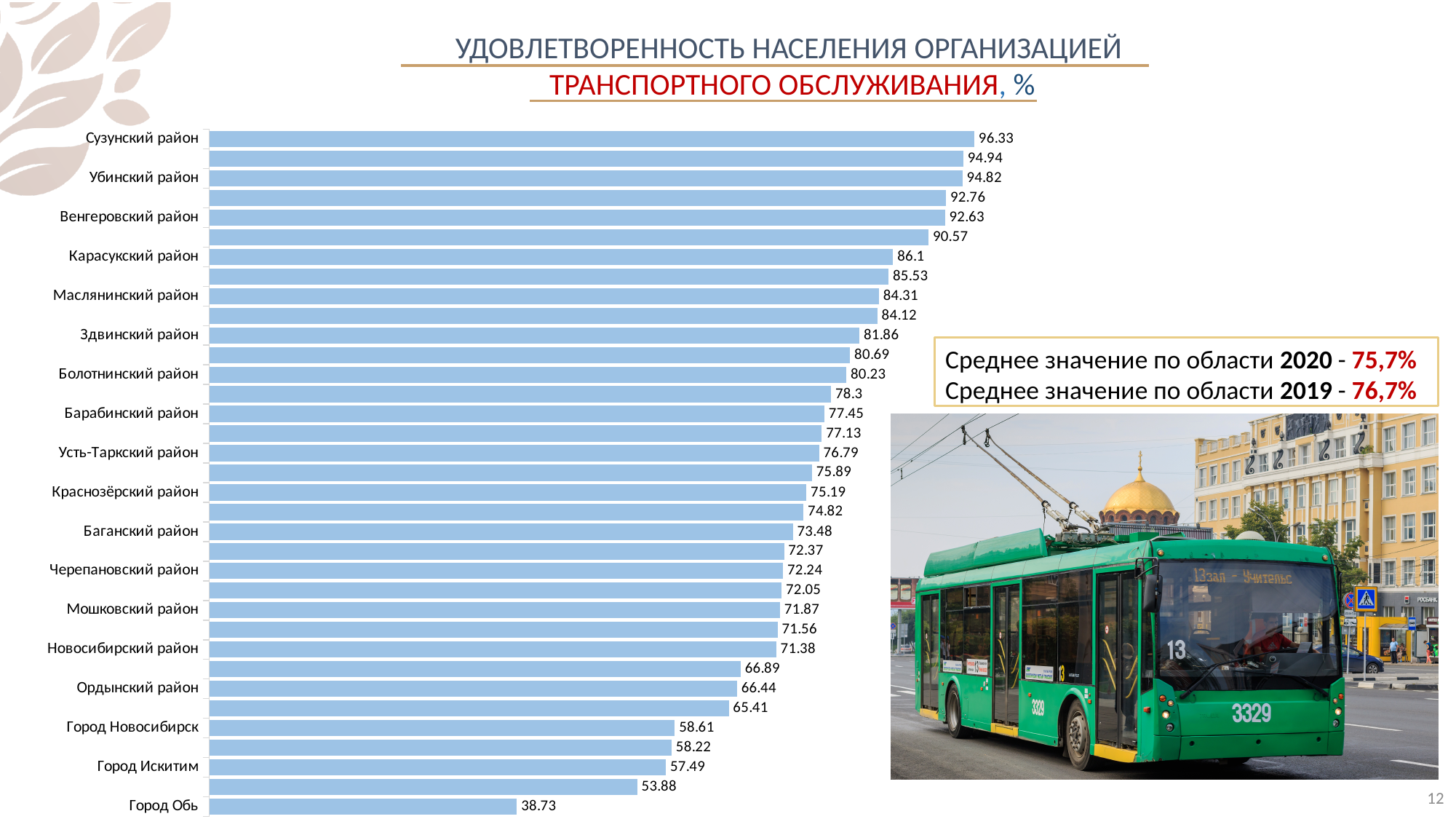
What is the value for Город Новосибирск? 58.61 Which is larger, the value for Здвинский район or the value for Баганский район? Здвинский район Which category has the highest value? Сузунский район What is the value for Город Обь? 38.73 What kind of chart is shown on the slide? Bar chart What is the value for Сузунский район? 96.33 Which category has the lowest value? Город Обь According to the text box on the slide, what was the regional average value in 2020? 75,7% What is the value for Карасукский район? 86.1 What is the difference between the values for Карасукский район and Маслянинский район? 1.79 What is the value for Ордынский район? 66.44 What is the difference between the values for Сузунский район and Город Обь? 57.6